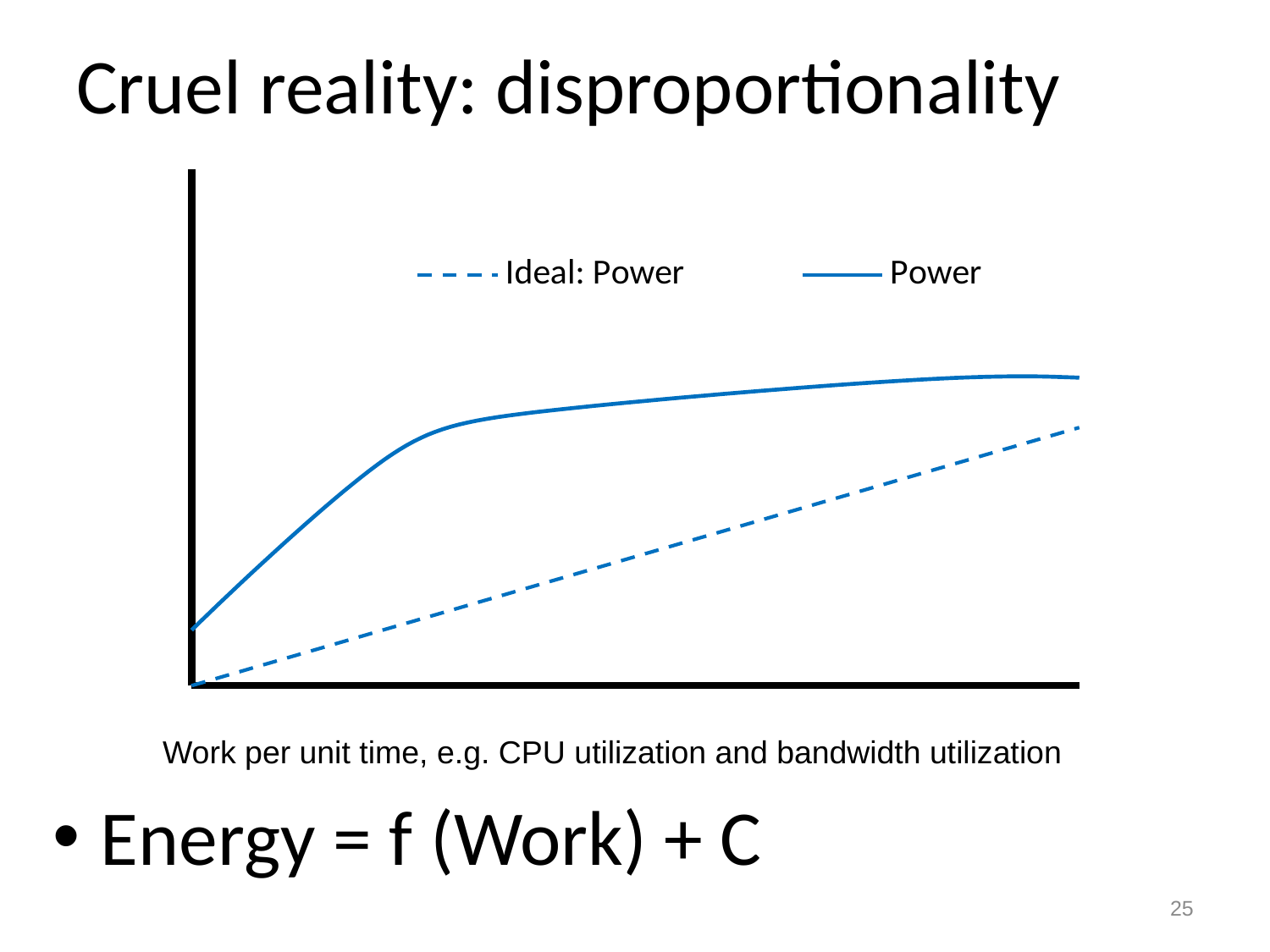
Which series lies above the other across the chart, Power or Ideal: Power? Power Which series is plotted as a straight line, Power or Ideal: Power? Ideal: Power What kind of chart is shown on the slide? Line chart How many series does the chart's legend list? 2 At the right end of the chart, which series has the higher value, Power or Ideal: Power? Power Does the Ideal: Power line rise or fall along the x axis? Rises Which series is drawn with a dashed line? Ideal: Power Does the Power line rise or fall as work per unit time increases along the x axis? Rises What are the two series named in the chart's legend? Ideal: Power and Power